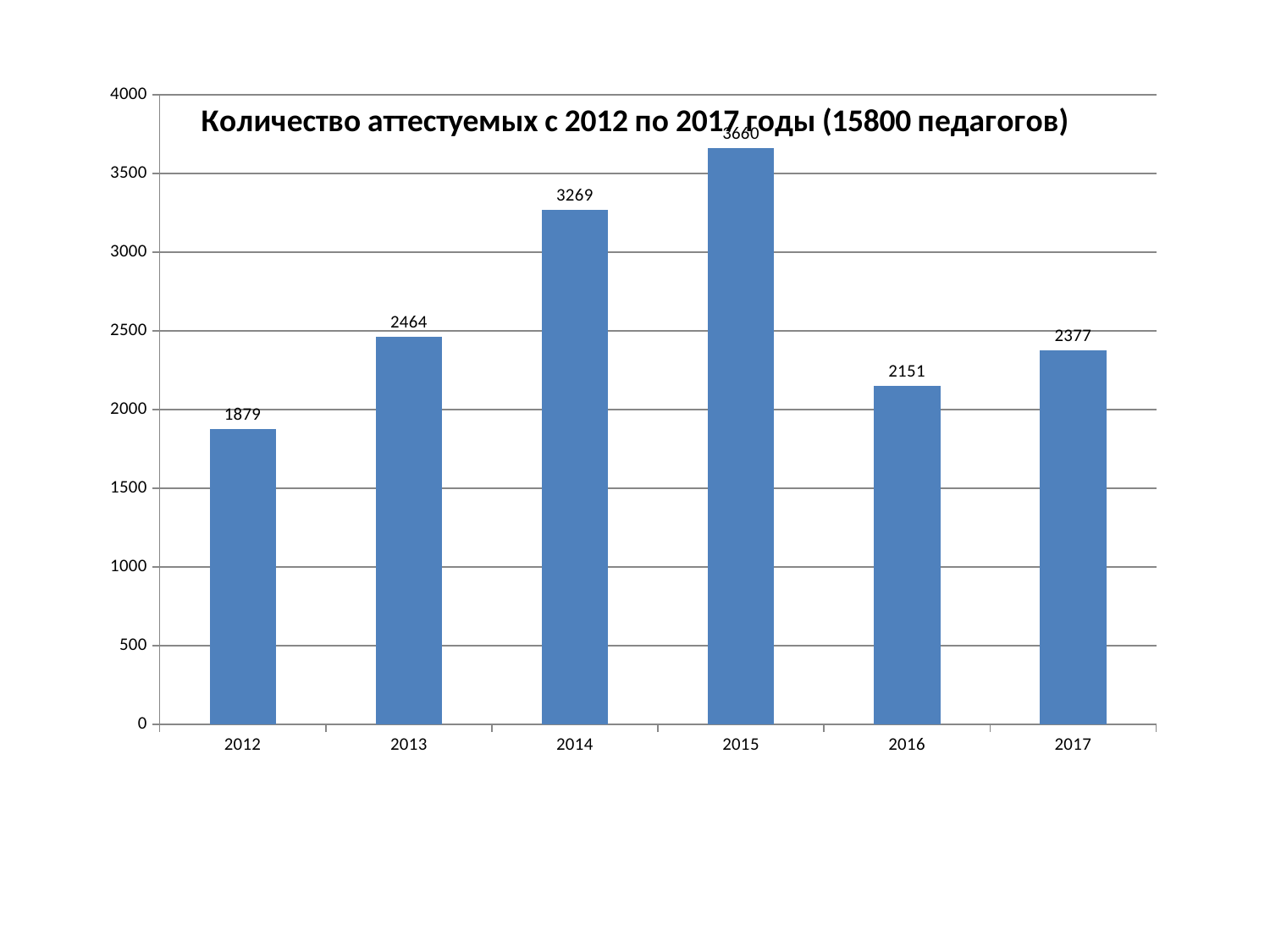
What is the value for 2016? 2151 What is the value for 2012? 1879 Is the value for 2013 greater or less than 2000? greater What kind of chart is this? bar chart Which year has the highest value? 2015 What is the title of the chart? Количество аттестуемых с 2012 по 2017 годы (15800 педагогов) What is the value for 2014? 3269 What is the difference between the values for 2017 and 2016? 226 Which year has the lowest value? 2012 What is the difference between the values for 2015 and 2014? 391 Which is larger, the value for 2013 or the value for 2017? 2013 How many years are shown on the x axis? 6